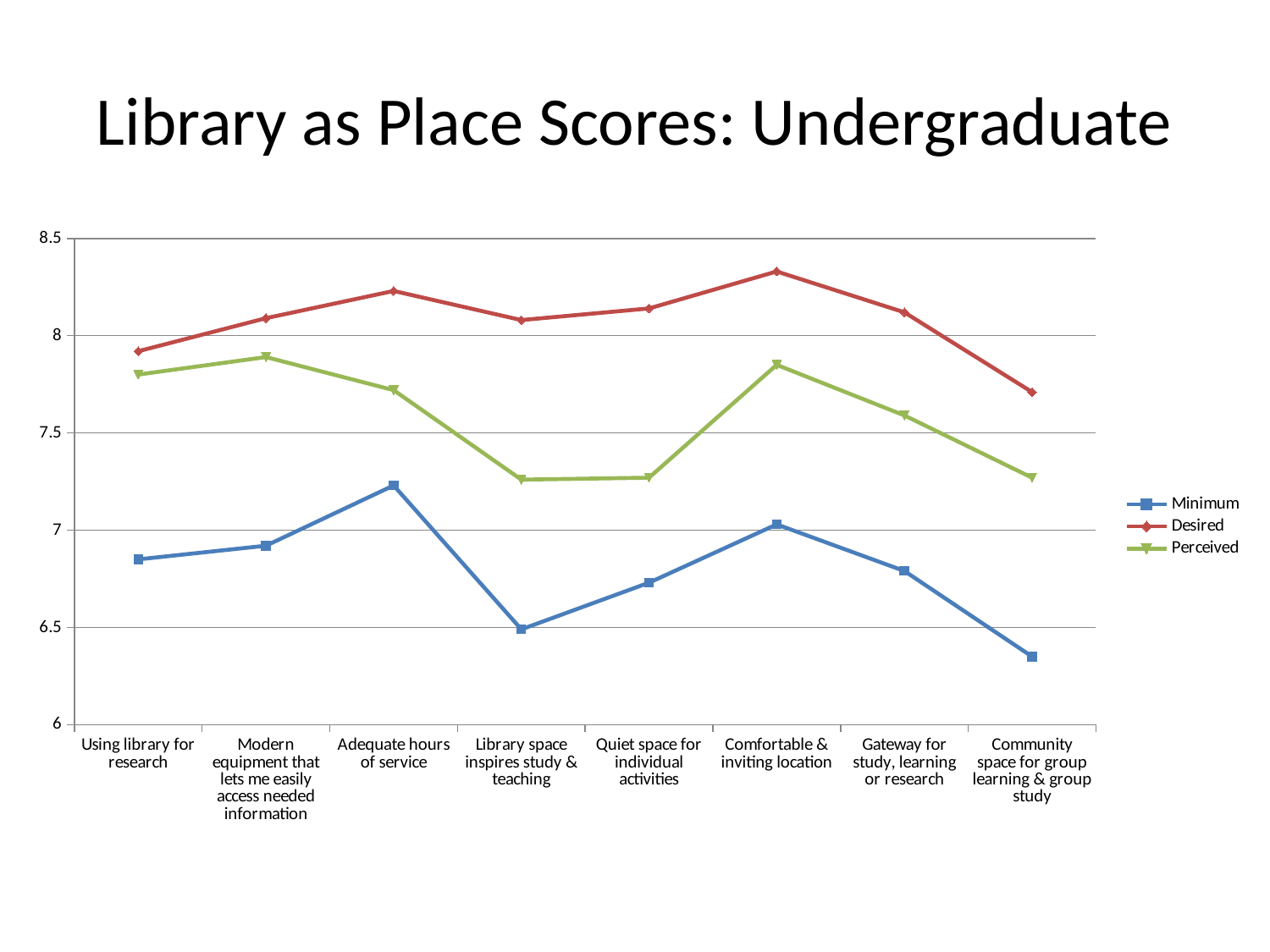
Which is larger for Quiet space for individual activities, the Desired score or the Perceived score? Desired How many categories are shown along the x axis? 8 Is the Minimum score for Community space for group learning & group study greater or less than 6.5? less Is the Desired score for Comfortable & inviting location greater or less than 8? greater For which category is the Desired score highest? Comfortable & inviting location What kind of chart is shown on the slide? line chart For which category is the Minimum score lowest? Community space for group learning & group study Which series is drawn in green? Perceived How many series does the legend list? 3 What is the title of the chart? Library as Place Scores: Undergraduate For which category is the Minimum score highest? Adequate hours of service Does the Minimum score rise or fall from Adequate hours of service to Library space inspires study & teaching? fall